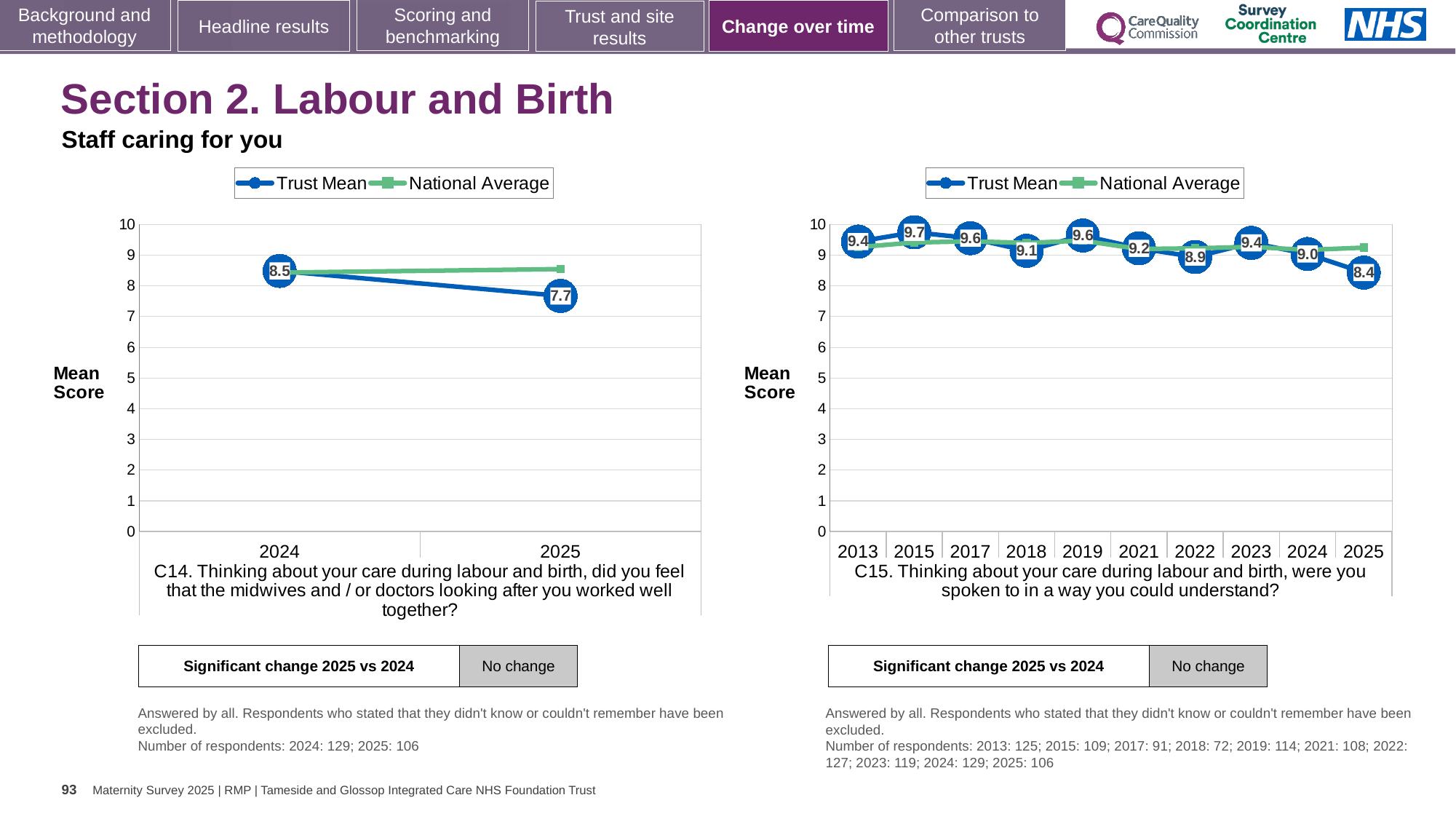
In the right chart (C15), what is the Trust Mean score for 2022? 8.9 How many series does the legend of the left chart (C14) list? 2 In the left chart (C14), what is the Trust Mean score for 2025? 7.7 In the right chart (C15), which year has the highest Trust Mean score? 2015 In the right chart (C15), which year has the lowest Trust Mean score? 2025 In the left chart (C14), by how much did the Trust Mean fall from 2024 to 2025? 0.8 In the left chart (C14), what is the Trust Mean score for 2024? 8.5 In the right chart (C15), how many years are plotted on the x axis? 10 In the right chart (C15), what is the difference between the Trust Mean scores for 2015 and 2025? 1.3 What type of chart is the right chart (C15)? line chart In the left chart (C14), does the Trust Mean rise or fall from 2024 to 2025? fall In the right chart (C15), which is larger, the Trust Mean for 2019 or for 2021? 2019